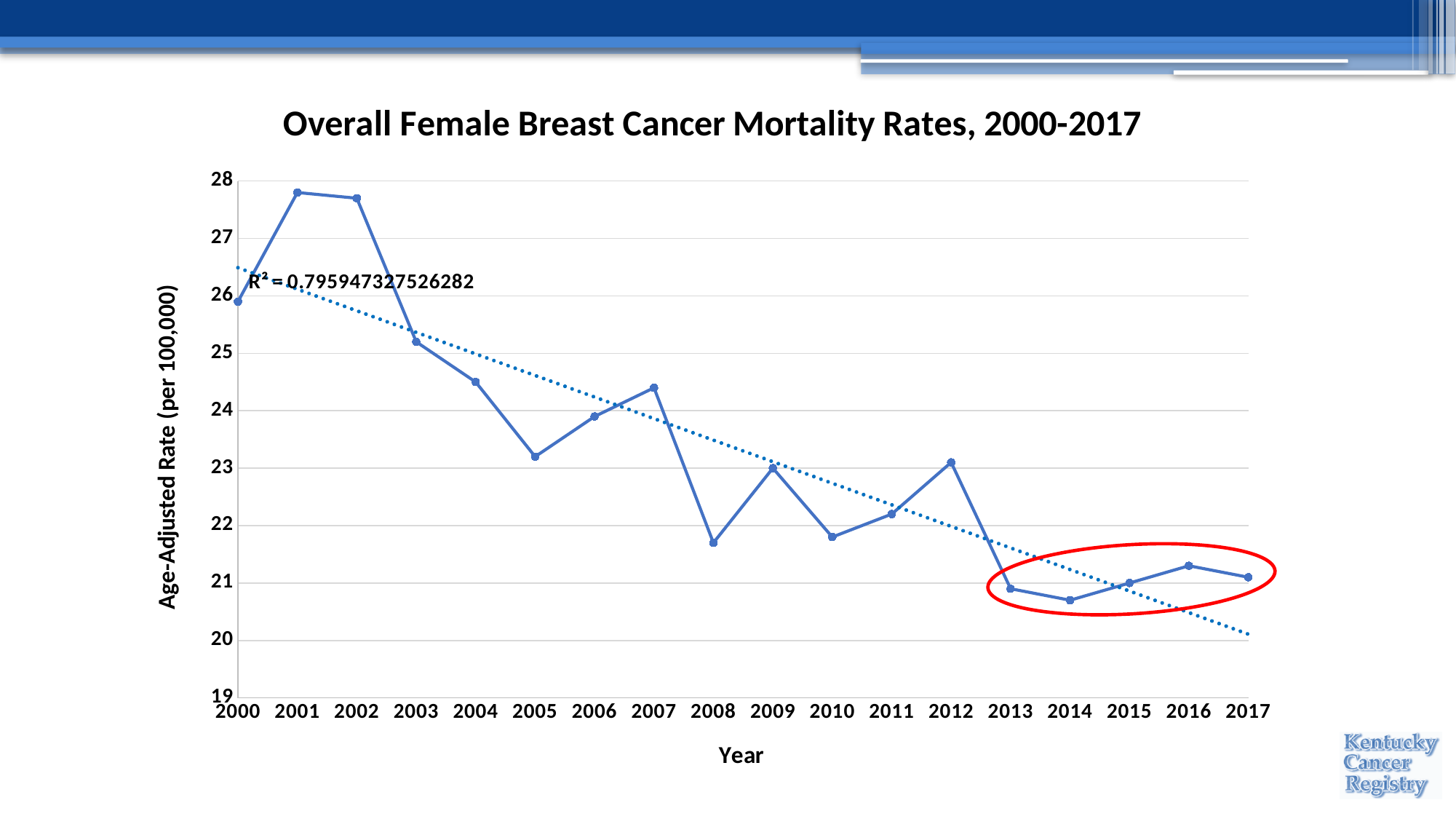
Is the value for 2007 greater or less than 24? greater Which year has the lowest age-adjusted mortality rate? 2014 Which year has the higher mortality rate, 2011 or 2012? 2012 Is the value for 2005 greater or less than 24? less What is the title of the chart? Overall Female Breast Cancer Mortality Rates, 2000-2017 What is the R² value printed on the chart? 0.795947327526282 Overall, do the mortality rates rise or fall from 2000 to 2017? Fall How many years (data points) are plotted on the chart? 18 Is the value for 2008 greater or less than 22? less Which year has the higher mortality rate, 2007 or 2008? 2007 What kind of chart is shown on the slide? Line chart